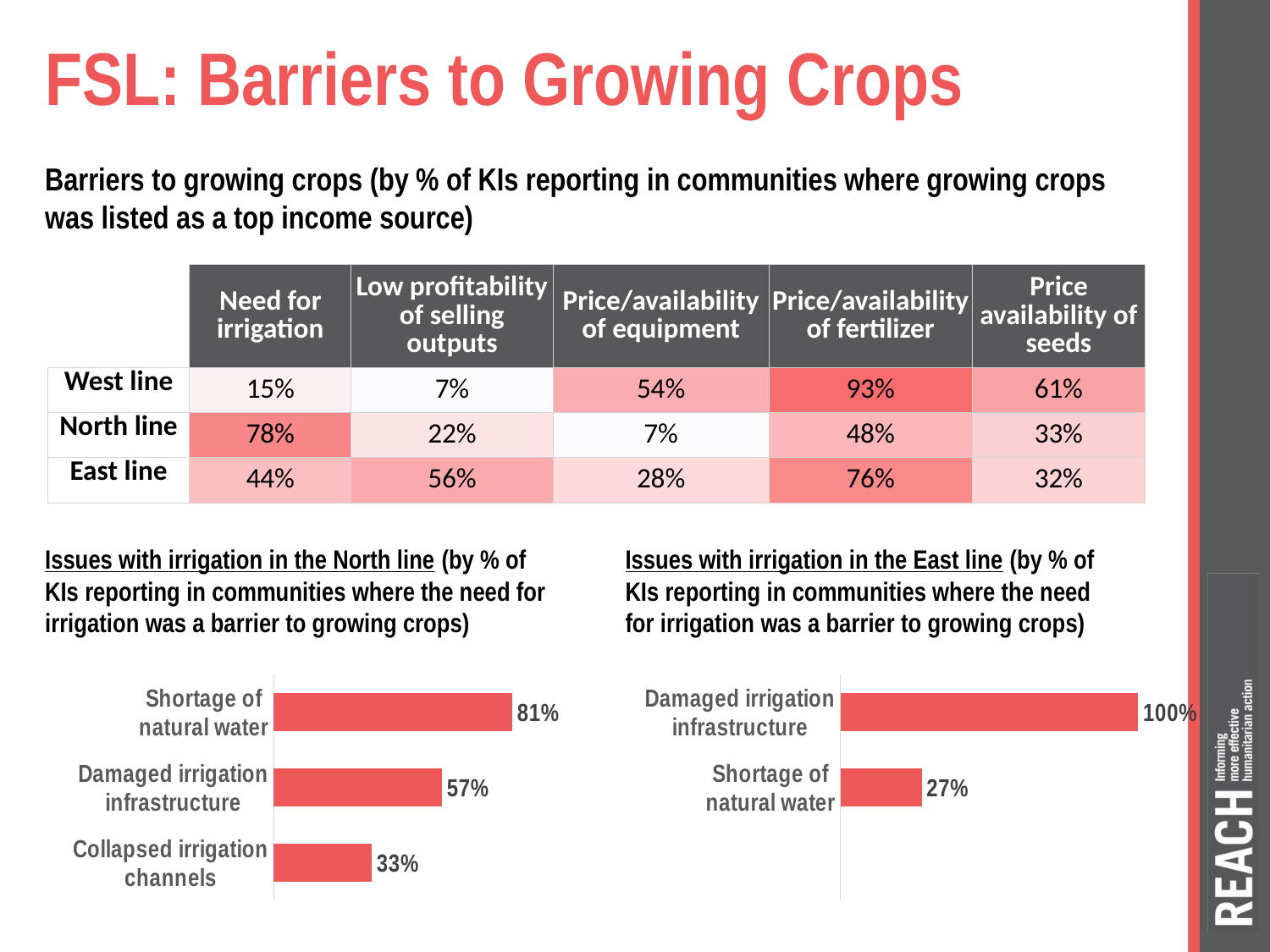
In the 'Issues with irrigation in the North line' chart, what is the difference between Shortage of natural water and Damaged irrigation infrastructure? 24% In the 'Issues with irrigation in the East line' chart, what is the value for Damaged irrigation infrastructure? 100% What kind of chart is the 'Issues with irrigation in the North line' chart? Bar chart In the 'Issues with irrigation in the North line' chart, what is the value for Damaged irrigation infrastructure? 57% In the 'Issues with irrigation in the North line' chart, which category has the lowest value? Collapsed irrigation channels In the 'Issues with irrigation in the North line' chart, what is the value for Shortage of natural water? 81% In the 'Issues with irrigation in the East line' chart, which category has the highest value? Damaged irrigation infrastructure In the 'Issues with irrigation in the East line' chart, what is the value for Shortage of natural water? 27% How many categories are shown in the 'Issues with irrigation in the North line' chart? 3 In the 'Issues with irrigation in the East line' chart, what is the difference between Damaged irrigation infrastructure and Shortage of natural water? 73% In the 'Issues with irrigation in the North line' chart, what is the value for Collapsed irrigation channels? 33% Which is larger: Shortage of natural water in the North line chart or Shortage of natural water in the East line chart? North line chart